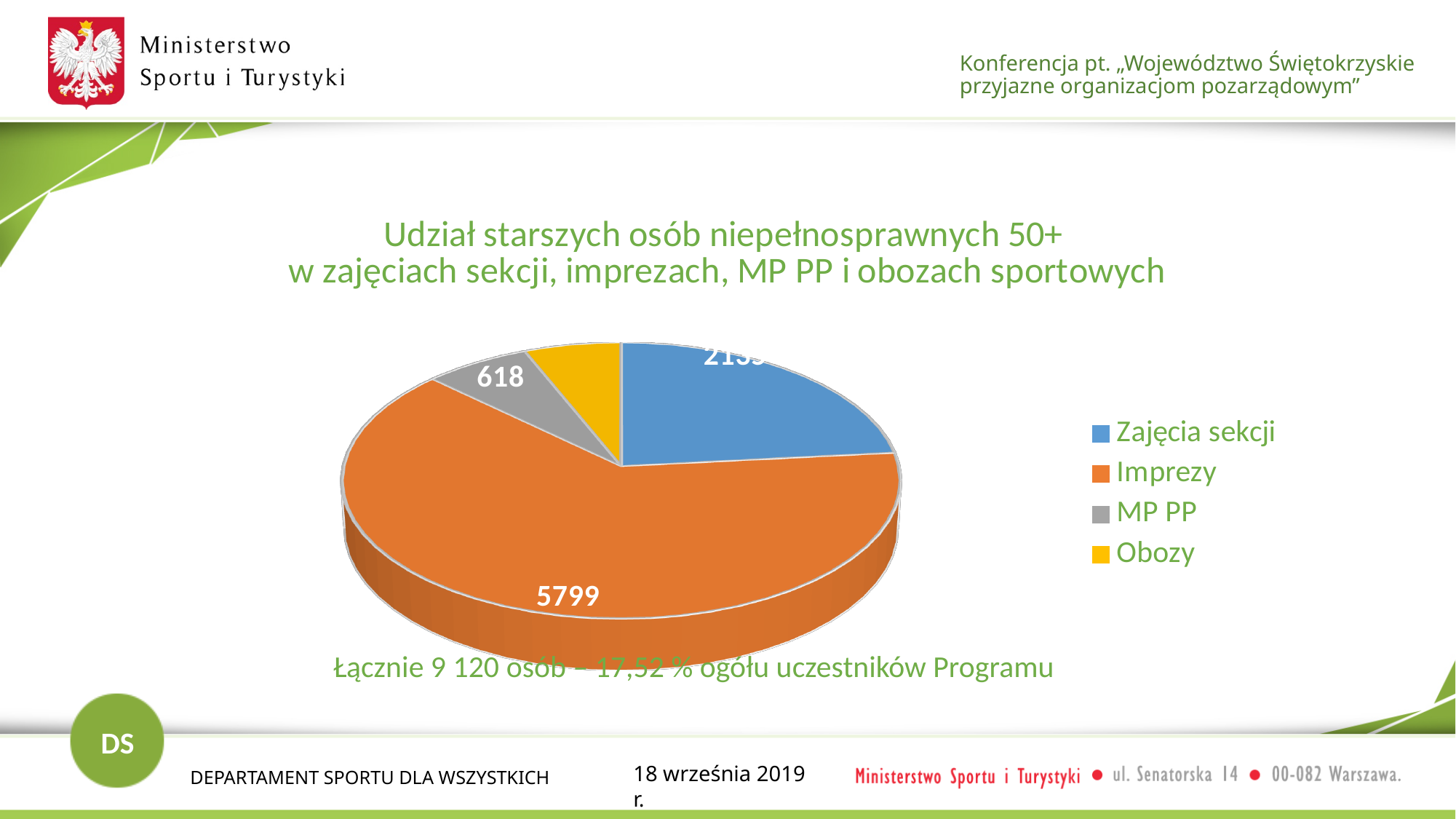
How many categories does the pie chart show? 4 How many entries does the legend list? 4 Which category has the largest slice of the pie chart? Imprezy What value is shown for the Imprezy slice of the pie chart? 5799 According to the text below the chart, how many people in total are represented? 9 120 Which colour represents Imprezy in the pie chart? Orange What is the difference between the Imprezy value and the MP PP value? 5181 What kind of chart is shown on the slide? Pie chart What value is shown for the MP PP slice of the pie chart? 618 Which is larger, the Imprezy slice or the MP PP slice? Imprezy Which category has the smallest slice of the pie chart? Obozy